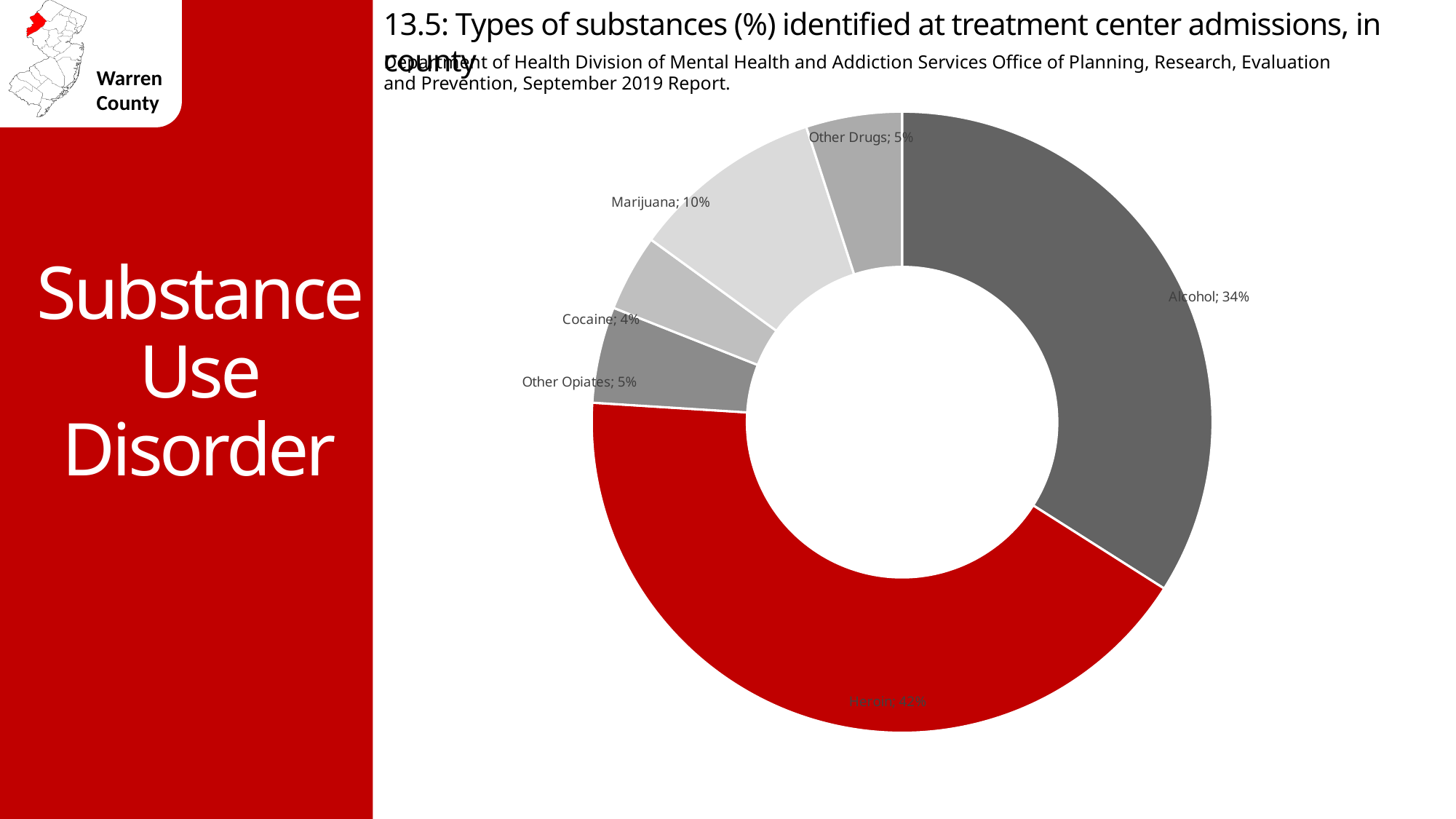
Which slice of the chart is coloured red? Heroin Which is larger, the share for Marijuana or the share for Other Drugs? Marijuana What percentage is shown for Alcohol? 34% What is the difference in percentage points between Heroin and Alcohol? 8 What percentage of treatment center admissions is attributed to Heroin? 42% What kind of chart is used on this slide? Pie chart (doughnut) What percentage is shown for Marijuana? 10% Which substance has the smallest share of admissions? Cocaine What percentage is shown for Cocaine? 4% Which substance has the largest share of admissions? Heroin What percentage is shown for Other Opiates? 5% How many substance categories are shown in the chart? 6